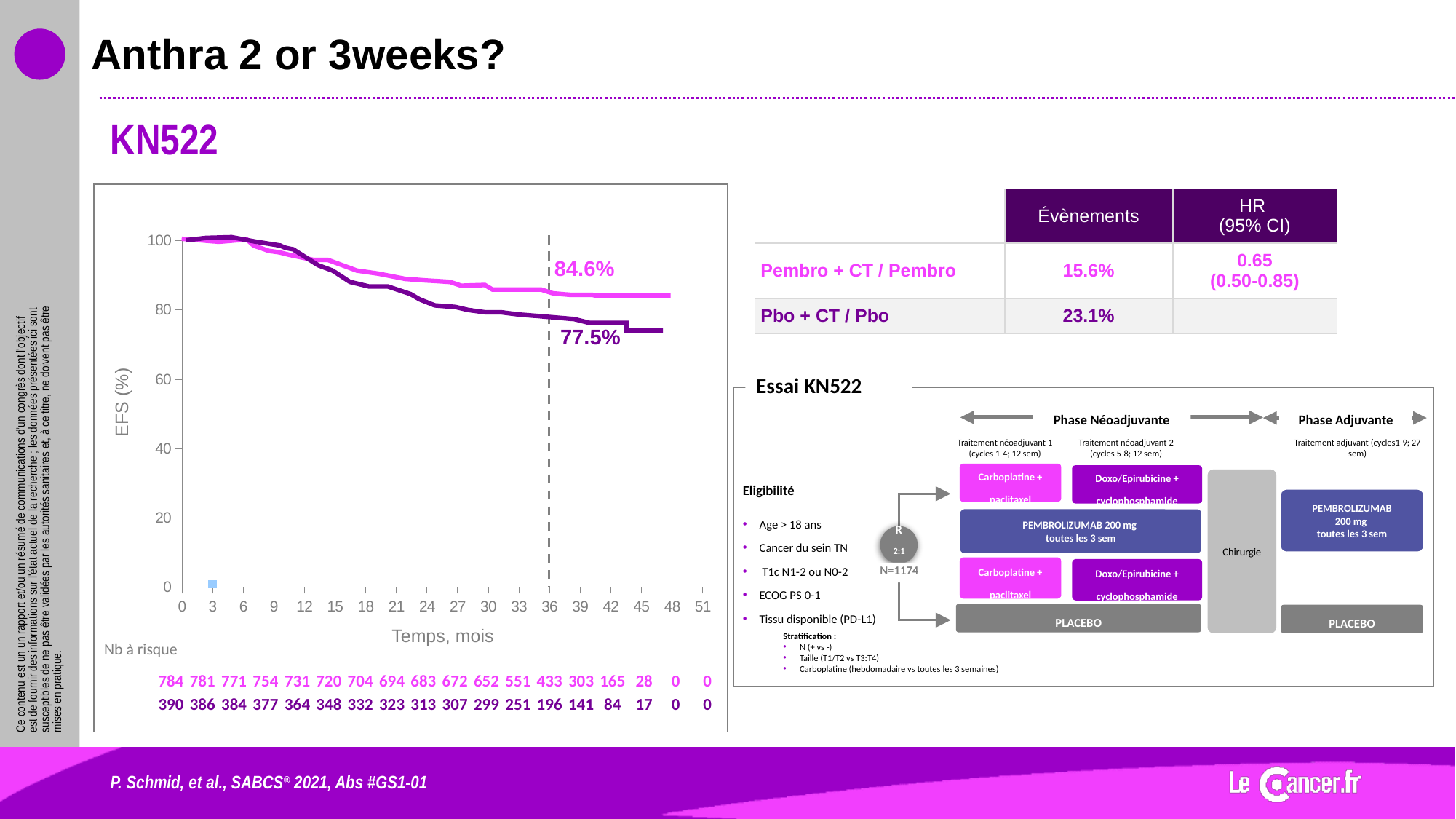
Is the purple (Pbo + CT) curve at 48 months greater or less than 80? less At 36 months, which curve has the higher labelled EFS value, the pink (Pembro + CT) or the purple (Pbo + CT)? pink (Pembro + CT) What is the label of the y axis of the chart? EFS (%) Is the pink (Pembro + CT) curve at 48 months greater or less than 80? greater What EFS value is labelled on the purple (Pbo + CT) curve at the dashed line at 36 months? 77.5% What EFS value is labelled on the pink (Pembro + CT) curve at the dashed line at 36 months? 84.6% In the 'Nb à risque' rows below the chart, how many patients are at risk at 0 months in the pink (Pembro + CT) row? 784 Do the EFS curves rise or fall as time in months increases? fall What is the difference between the labelled EFS values of the pink and purple curves at 36 months? 7.1 percentage points In the 'Nb à risque' rows below the chart, how many patients are at risk at 36 months in the purple (Pbo + CT) row? 196 What is the label of the x axis of the chart? Temps, mois What kind of chart is shown on the left of the slide? line chart